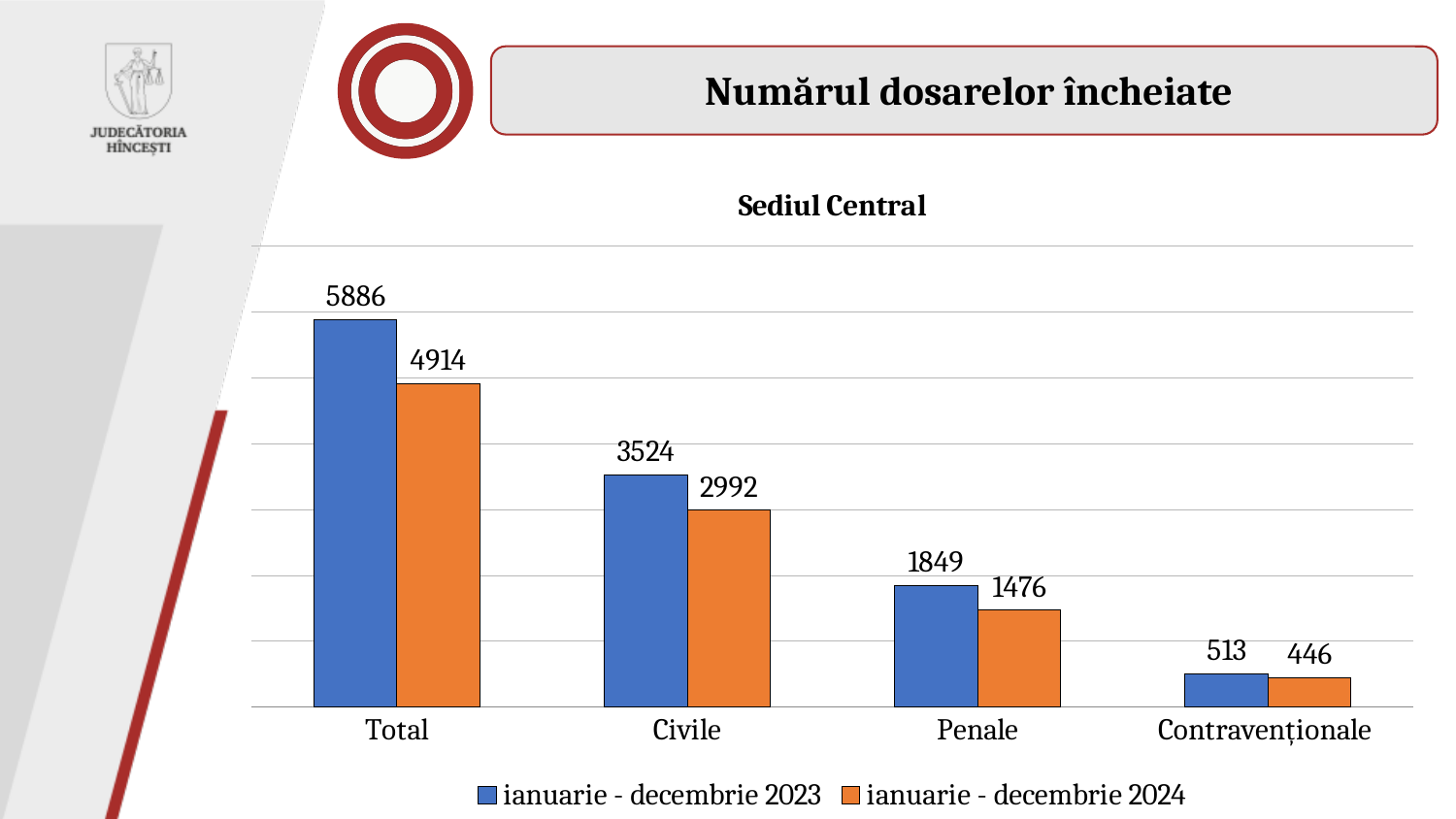
How many categories are shown on the x axis? 4 What is the value for Civile in the ianuarie - decembrie 2023 series? 3524 What is the value for Penale in the ianuarie - decembrie 2024 series? 1476 What kind of chart is shown on the slide? Bar chart What is the value for Contravenționale in the ianuarie - decembrie 2023 series? 513 What is the Total value for ianuarie - decembrie 2024? 4914 What is the difference between the Total values for 2023 and 2024? 972 Which category has the highest value in the ianuarie - decembrie 2023 series? Total How many series does the legend list? 2 Which category has the lowest value in the ianuarie - decembrie 2024 series? Contravenționale What is the difference between the Civile values for 2023 and 2024? 532 Which is larger: Penale in 2023 or Penale in 2024? Penale in 2023